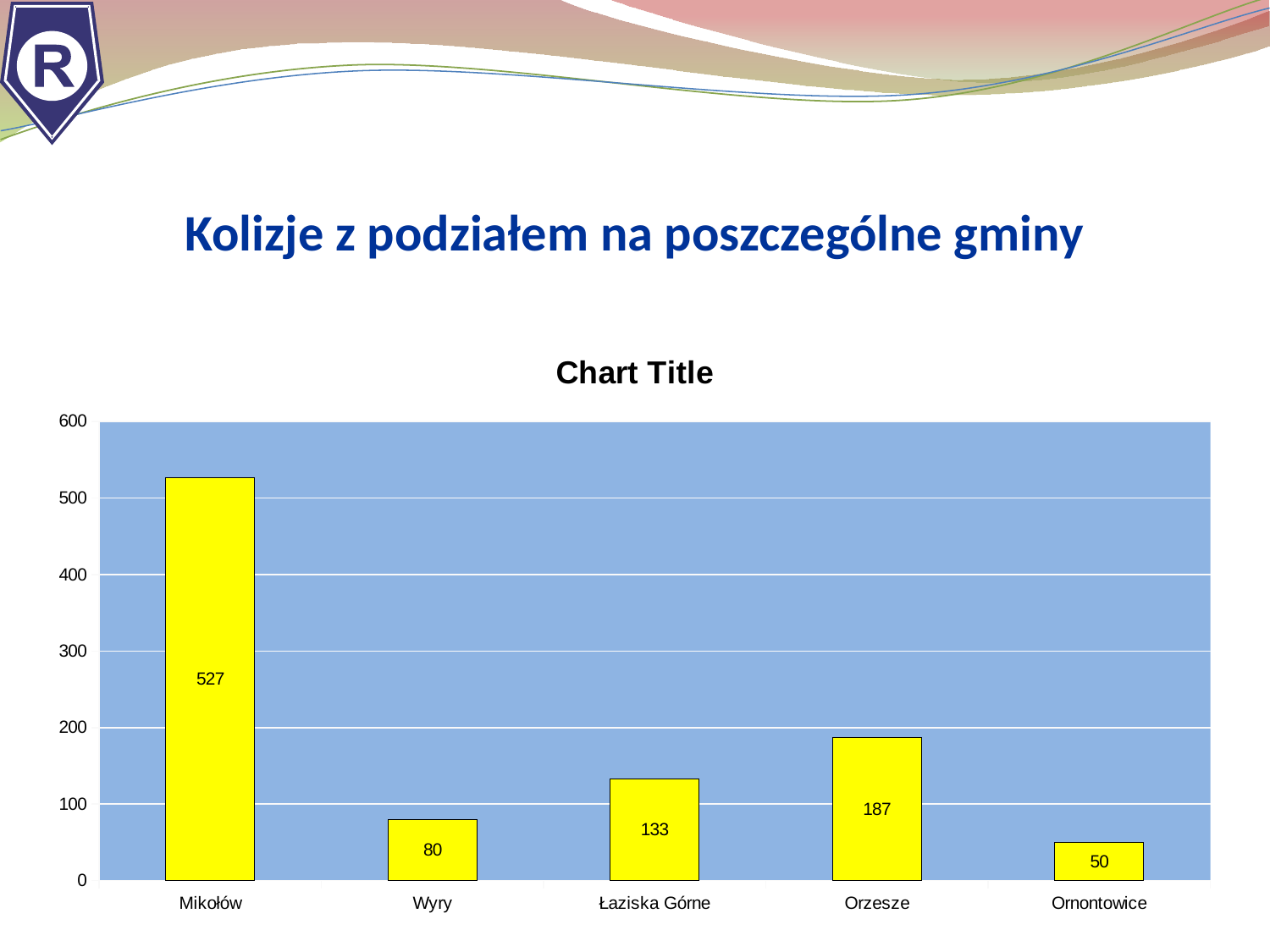
Which is larger, the value for Wyry or the value for Łaziska Górne? Łaziska Górne What is the title of the slide? Kolizje z podziałem na poszczególne gminy What is the value for Łaziska Górne? 133 What is the value for Mikołów? 527 Which category has the highest value? Mikołów What kind of chart is shown on the slide? bar chart What is the value for Orzesze? 187 How many categories are shown on the x axis? 5 What is the difference between the values for Wyry and Ornontowice? 30 What is the difference between the values for Mikołów and Orzesze? 340 Is the value for Orzesze greater or less than 200? less Which category has the lowest value? Ornontowice